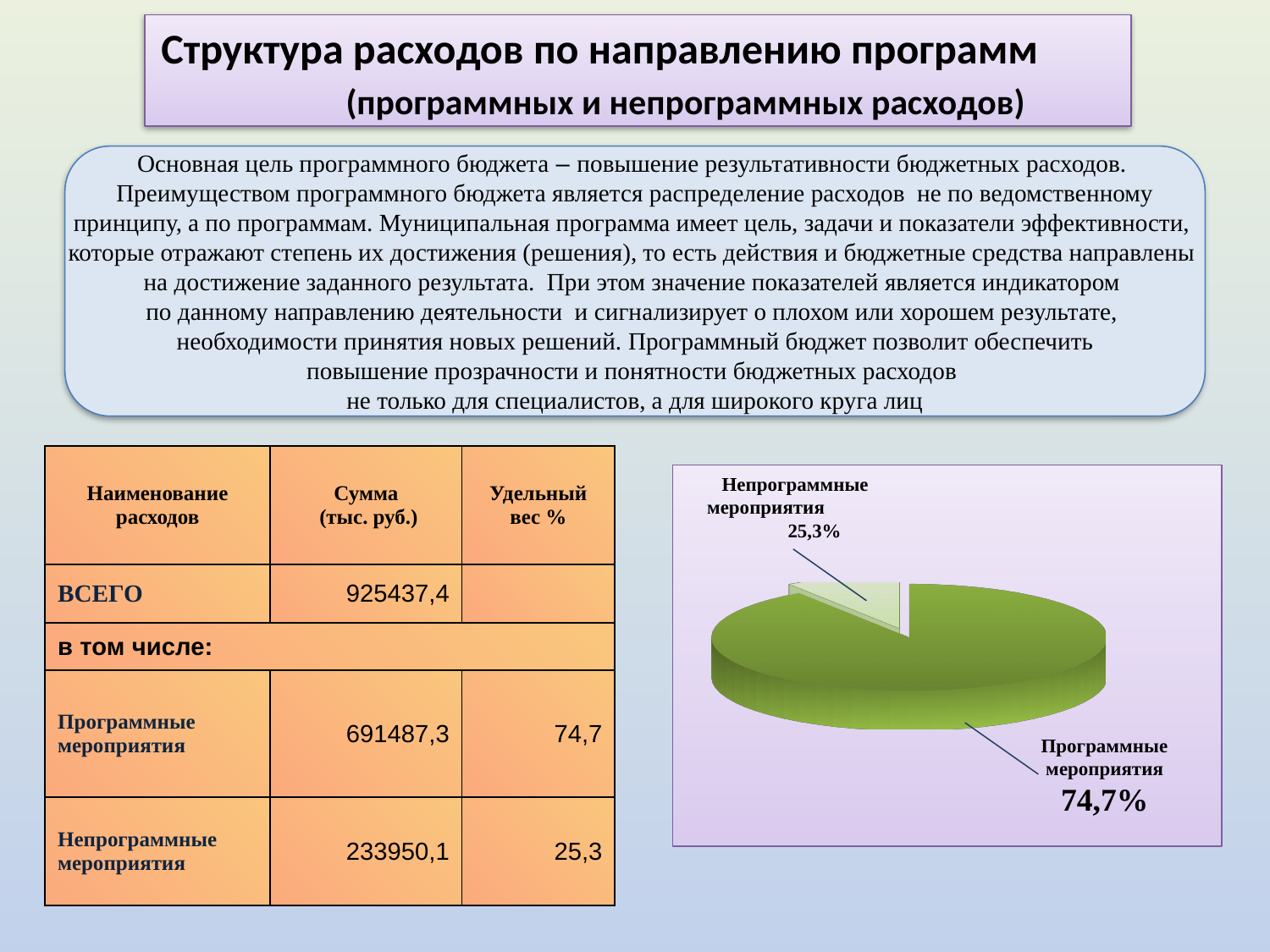
Is the share of Программные мероприятия in the pie chart greater or less than 50%? greater What kind of chart is shown on the slide? pie chart Which slice is pulled out (exploded) from the pie chart? Непрограммные мероприятия What colour is the Программные мероприятия slice in the pie chart? green What share of the pie does Непрограммные мероприятия have? 25,3% Is the share of Непрограммные мероприятия in the pie chart greater or less than 50%? less What is the difference in percentage points between the Программные мероприятия slice and the Непрограммные мероприятия slice? 49,4 Which slice of the pie chart is the smallest? Непрограммные мероприятия Which slice of the pie chart is the largest? Программные мероприятия Which is larger in the pie chart: Программные мероприятия or Непрограммные мероприятия? Программные мероприятия What share of the pie does Программные мероприятия have? 74,7% How many slices does the pie chart have? 2